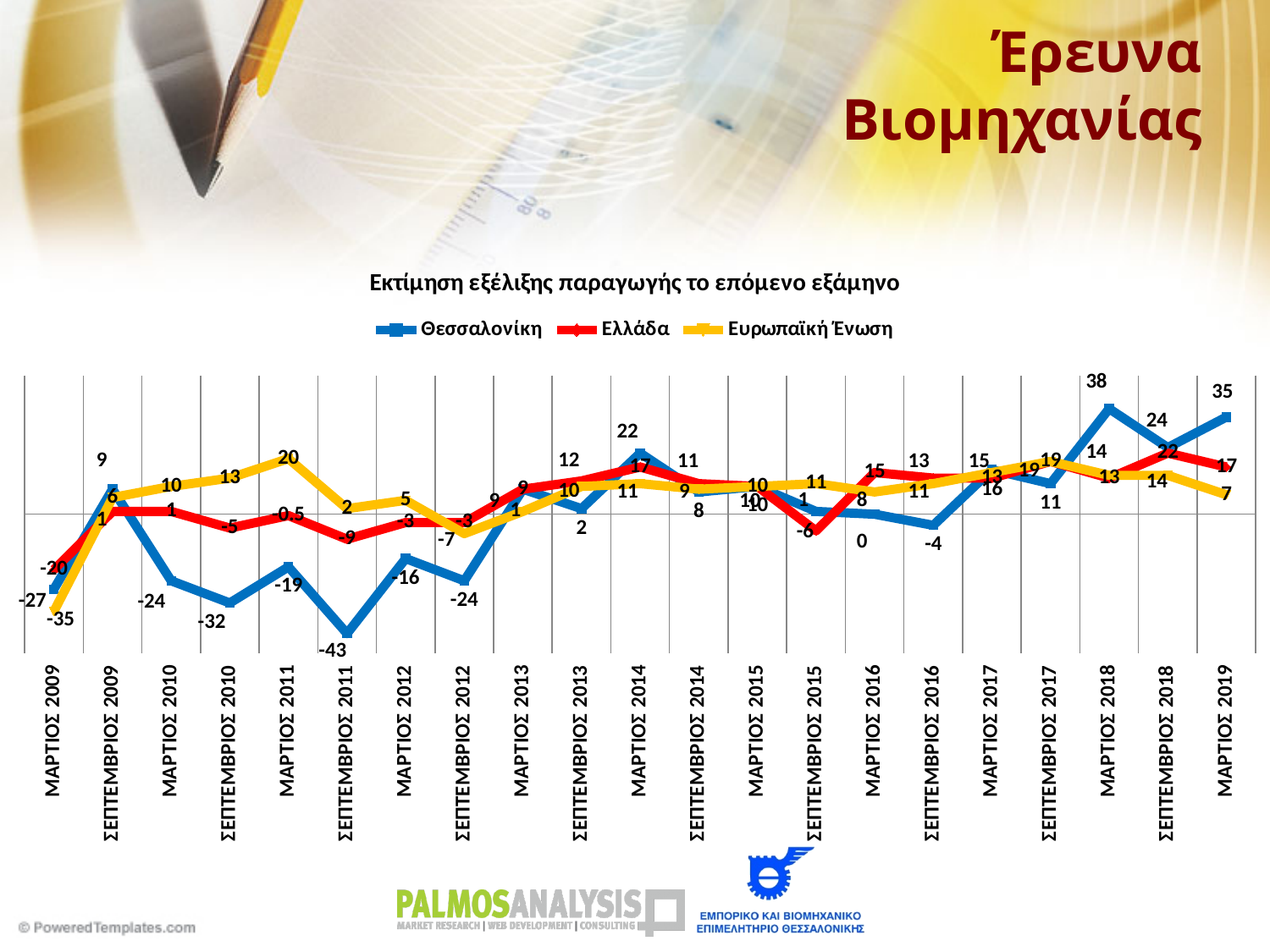
What is the title of the chart? Εκτίμηση εξέλιξης παραγωγής το επόμενο εξάμηνο What kind of chart is shown on the slide? line chart What is the difference between the Θεσσαλονίκη values in ΜΑΡΤΙΟΣ 2018 and ΜΑΡΤΙΟΣ 2019? 3 What is the value for Ευρωπαϊκή Ένωση in ΜΑΡΤΙΟΣ 2009? -35 What is the value for Θεσσαλονίκη in ΜΑΡΤΙΟΣ 2019? 35 In which period does Ευρωπαϊκή Ένωση reach its highest value? ΜΑΡΤΙΟΣ 2011 In which period does Θεσσαλονίκη reach its lowest value? ΣΕΠΤΕΜΒΡΙΟΣ 2011 In which period does Θεσσαλονίκη reach its highest value? ΜΑΡΤΙΟΣ 2018 In ΜΑΡΤΙΟΣ 2019, which is larger: the value for Θεσσαλονίκη or for Ευρωπαϊκή Ένωση? Θεσσαλονίκη What is the value for Θεσσαλονίκη in ΣΕΠΤΕΜΒΡΙΟΣ 2011? -43 How many time points are shown on the x axis? 21 How many series does the legend list? 3